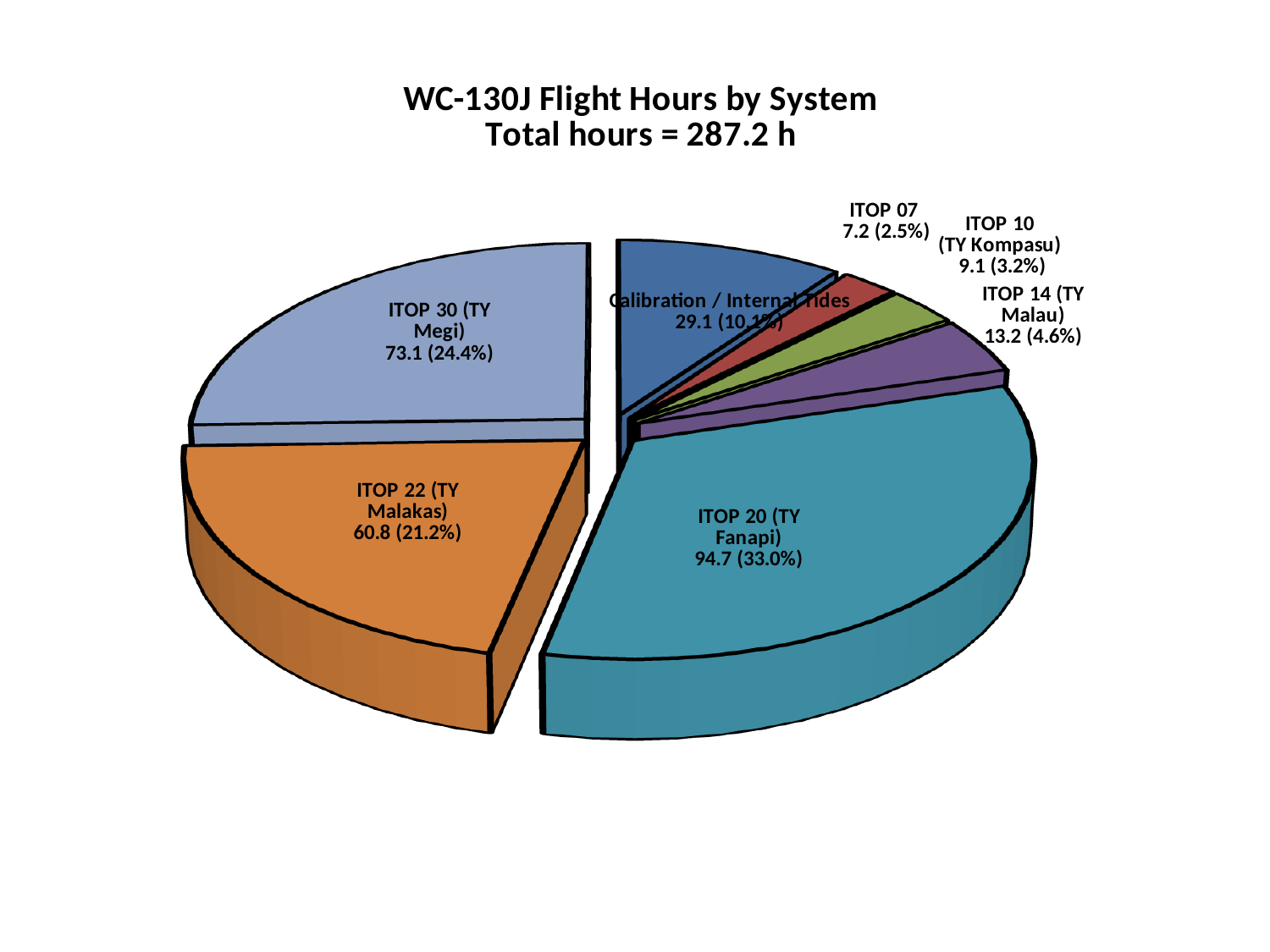
What is the difference in flight hours between ITOP 30 (TY Megi) and ITOP 22 (TY Malakas)? 12.3 How many flight hours are shown for ITOP 14 (TY Malau)? 13.2 How many slices does the pie chart have? 7 According to the chart title, what is the total number of flight hours? 287.2 h What share of the total flight hours does ITOP 30 (TY Megi) account for? 24.4% Which has more flight hours, ITOP 10 (TY Kompasu) or ITOP 14 (TY Malau)? ITOP 14 (TY Malau) Which system has the largest number of flight hours? ITOP 20 (TY Fanapi) What kind of chart is shown on the slide? pie chart What share of the total flight hours does ITOP 22 (TY Malakas) account for? 21.2% How many flight hours are shown for ITOP 20 (TY Fanapi)? 94.7 How many flight hours are shown for Calibration / Internal Tides? 29.1 Which system has the smallest number of flight hours? ITOP 07